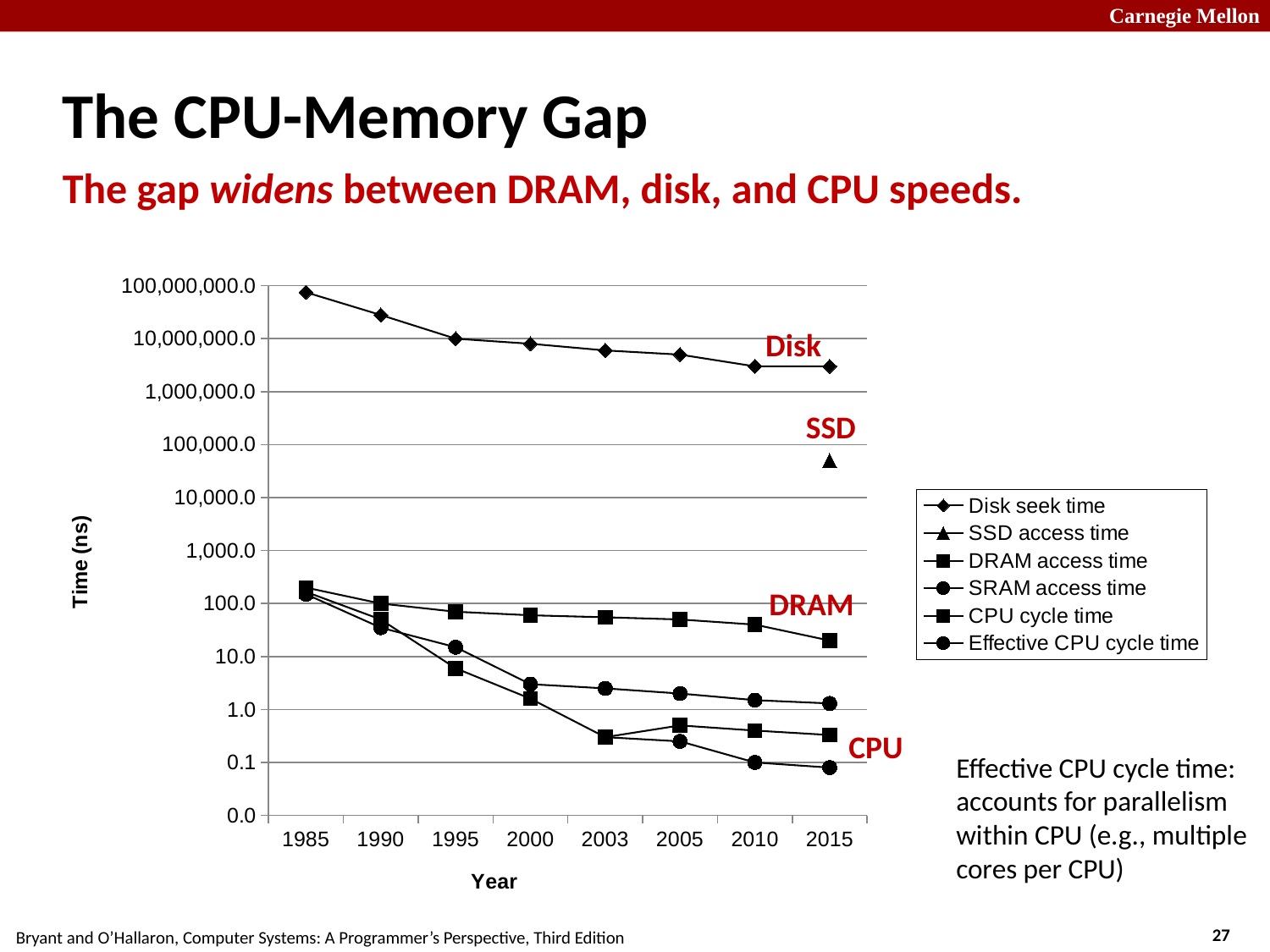
Is the CPU cycle time in 2015 greater or less than 1.0? less What is the label of the y axis? Time (ns) Which series has the highest value in 2015? Disk seek time Which series has the lowest value in 2015? Effective CPU cycle time Is the SSD access time in 2015 greater or less than 100,000.0? less How many series does the legend list? 6 What kind of chart is shown on the slide? line chart Is the Disk seek time in 1985 greater or less than 10,000,000.0? greater How many years are shown on the x axis? 8 Does the Disk seek time rise or fall from 1985 to 2015? fall